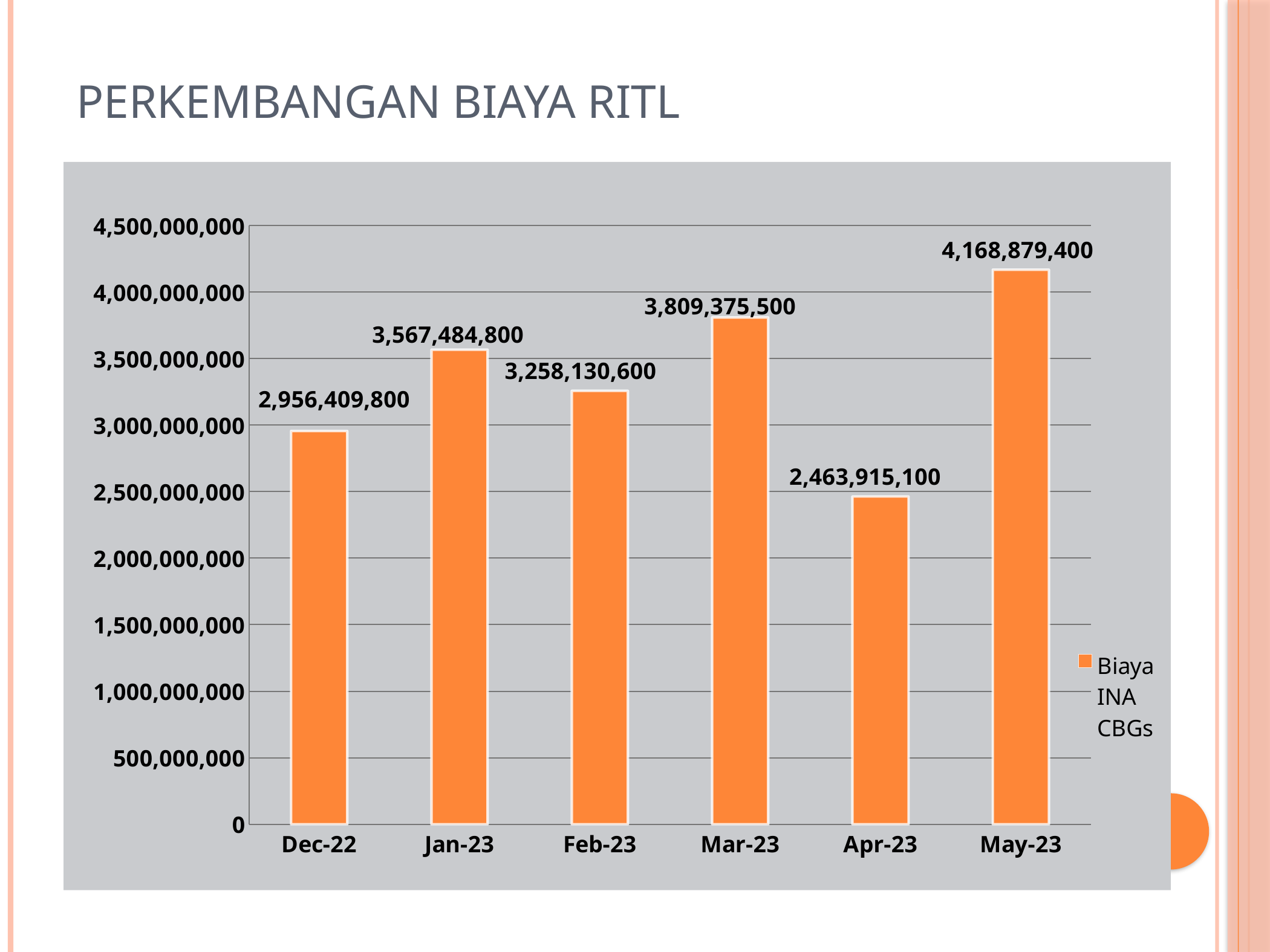
What is the difference between the values for Jan-23 and Dec-22? 611,075,000 How many series does the legend list? 1 What is the difference between the values for May-23 and Apr-23? 1,704,964,300 What kind of chart is shown on the slide? bar chart Which month has the highest value? May-23 What is the name of the series in the legend? Biaya INA CBGs Which is larger, the value for Jan-23 or the value for Feb-23? Jan-23 How many months are shown on the x axis? 6 What is the value for Mar-23? 3,809,375,500 Which month has the lowest value? Apr-23 What is the value for Dec-22? 2,956,409,800 Is the value for Apr-23 greater or less than 2,500,000,000? less